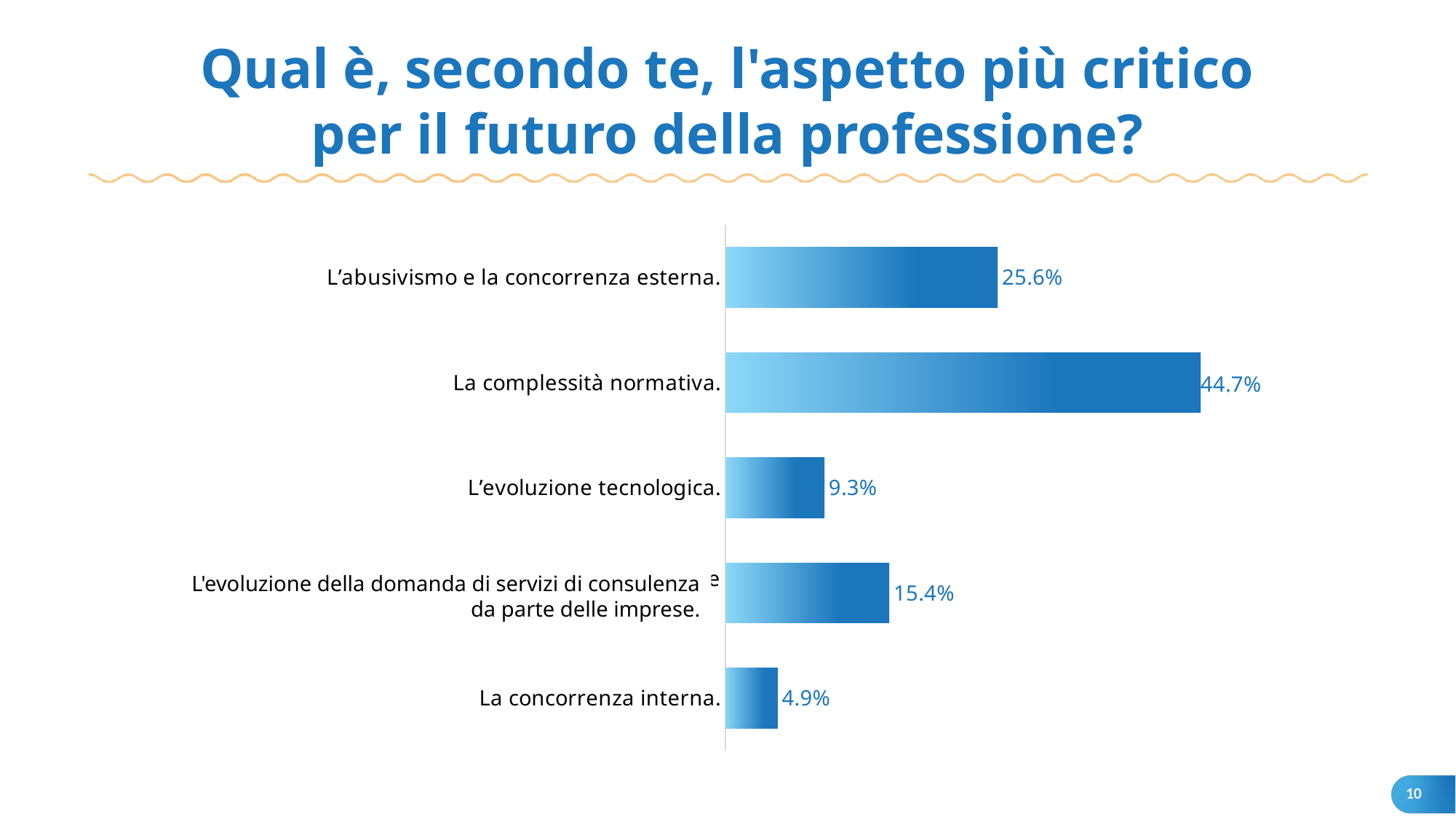
What is the difference between the values for "L'evoluzione tecnologica" and "La concorrenza interna"? 4.4% What is the value for "L'evoluzione tecnologica"? 9.3% Which category has the highest value? La complessità normativa What is the value for "L'evoluzione della domanda di servizi di consulenza da parte delle imprese"? 15.4% Which is larger: the value for "L'evoluzione tecnologica" or the value for "L'evoluzione della domanda di servizi di consulenza da parte delle imprese"? L'evoluzione della domanda di servizi di consulenza da parte delle imprese What is the value for "L'abusivismo e la concorrenza esterna"? 25.6% What is the difference between the values for "La complessità normativa" and "L'abusivismo e la concorrenza esterna"? 19.1% How many categories are shown in the chart? 5 What is the value for "La concorrenza interna"? 4.9% What is the value for "La complessità normativa"? 44.7% What kind of chart is shown on the slide? Bar chart Which category has the lowest value? La concorrenza interna